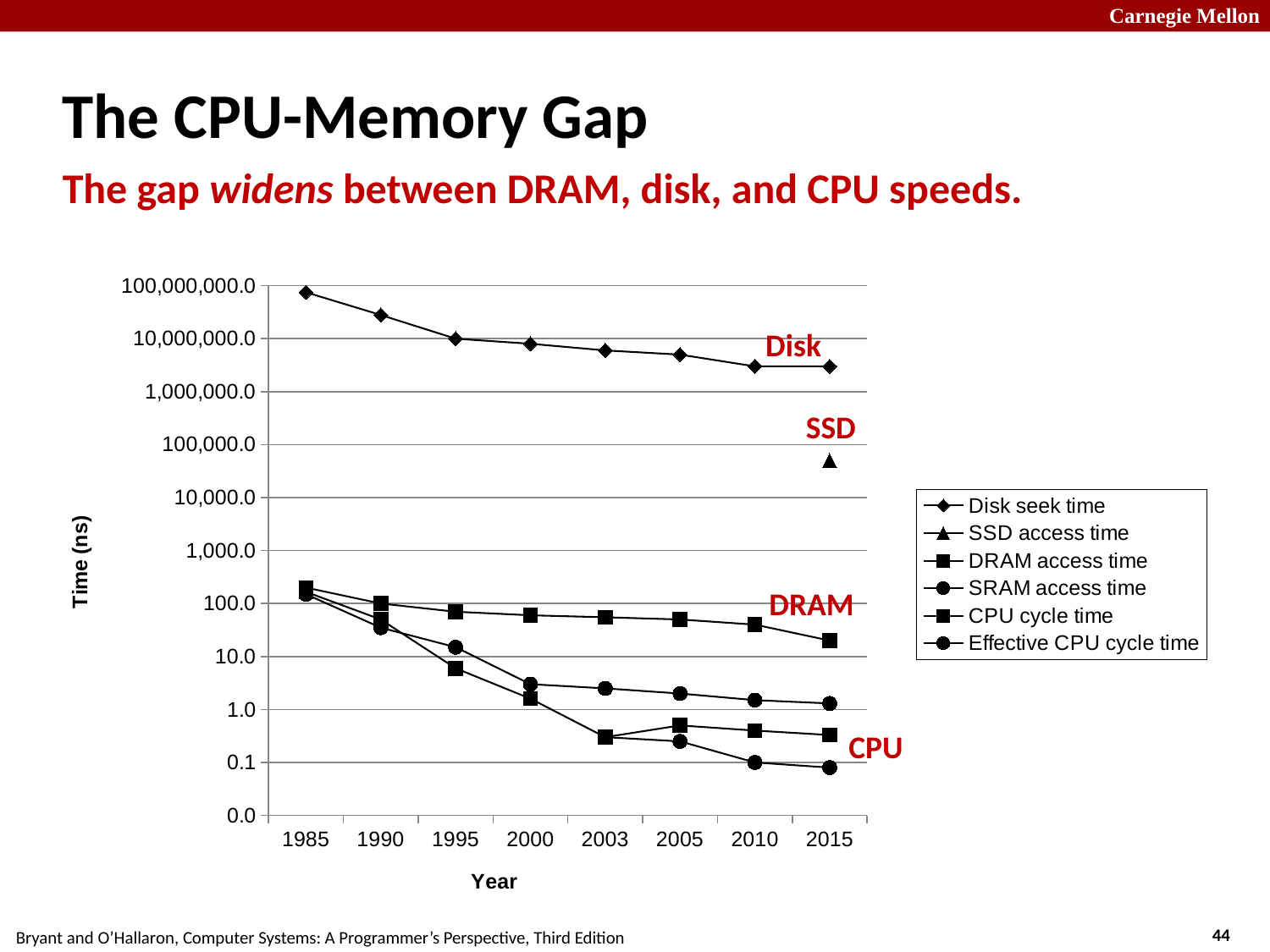
Which series has the highest value in 2015? Disk seek time Is the SSD access time value for 2015 greater or less than 100,000.0? less What is the title of the y axis? Time (ns) Which series has the lowest value in 2015? Effective CPU cycle time In 2015, which is larger: Disk seek time or DRAM access time? Disk seek time Is the Disk seek time value for 2015 greater or less than 1,000,000.0? greater Is the DRAM access time value for 2015 greater or less than 100.0? less Does the Disk seek time series rise or fall from 1985 to 2015? fall How many series does the legend list? 6 How many years are shown along the x axis? 8 What kind of chart is shown on the slide? line chart